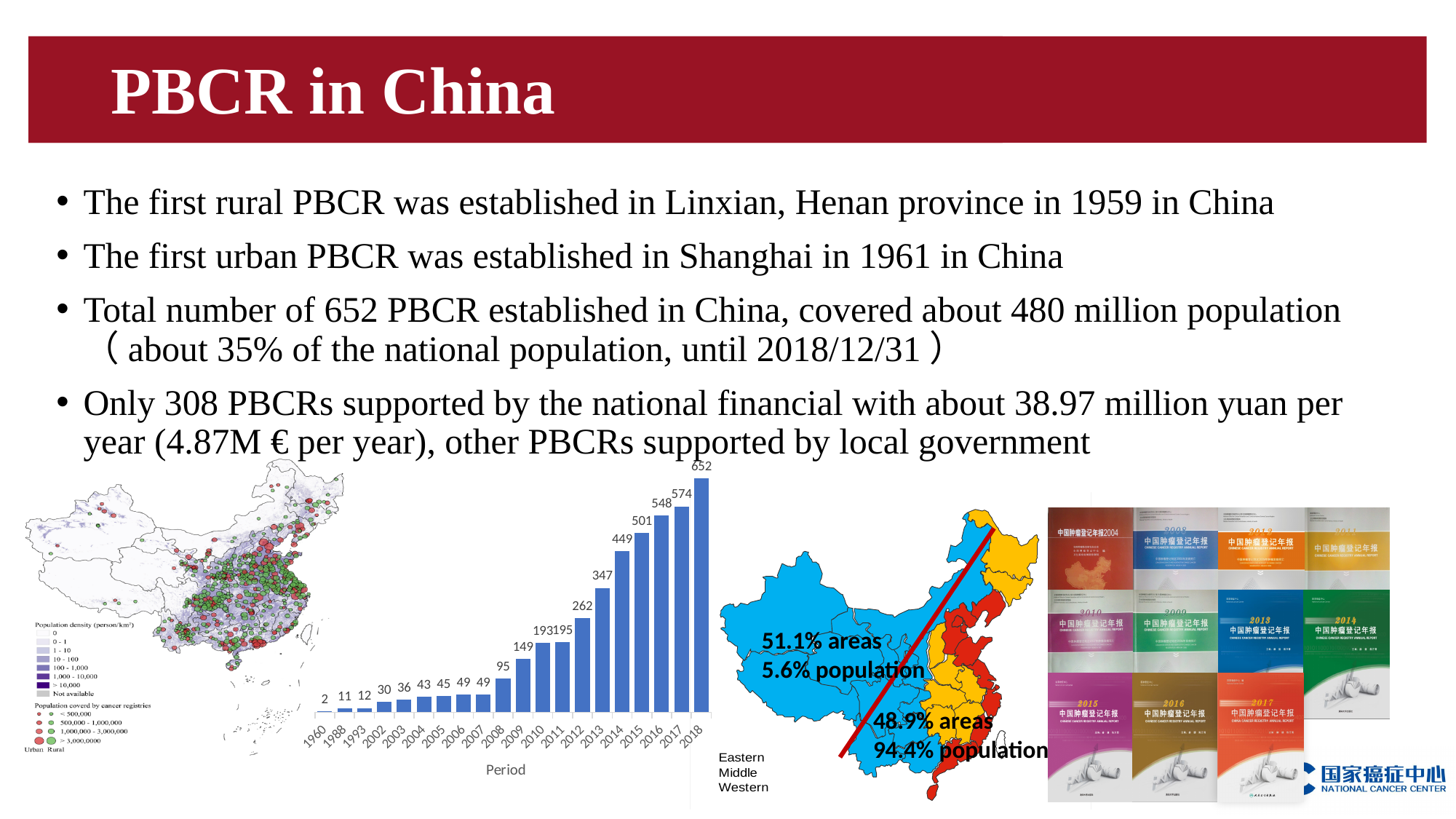
In the bar chart, what is the value for 2013? 347 In the bar chart, what is the difference between the values for 2009 and 2008? 54 In the bar chart, which is larger, the value for 2012 or the value for 2011? 2012 In the bar chart, which period has the highest value? 2018 In the bar chart, what is the value for 2018? 652 In the bar chart, what is the difference between the values for 2018 and 2017? 78 In the bar chart, which period has the lowest value? 1960 In the bar chart, do the values generally rise or fall from 1960 to 2018? rise In the bar chart, what is the value for 2008? 95 How many periods (bars) are shown in the bar chart? 20 In the bar chart, what is the value for 1960? 2 What type of chart is shown in the middle of the slide with the x-axis labelled "Period"? bar chart